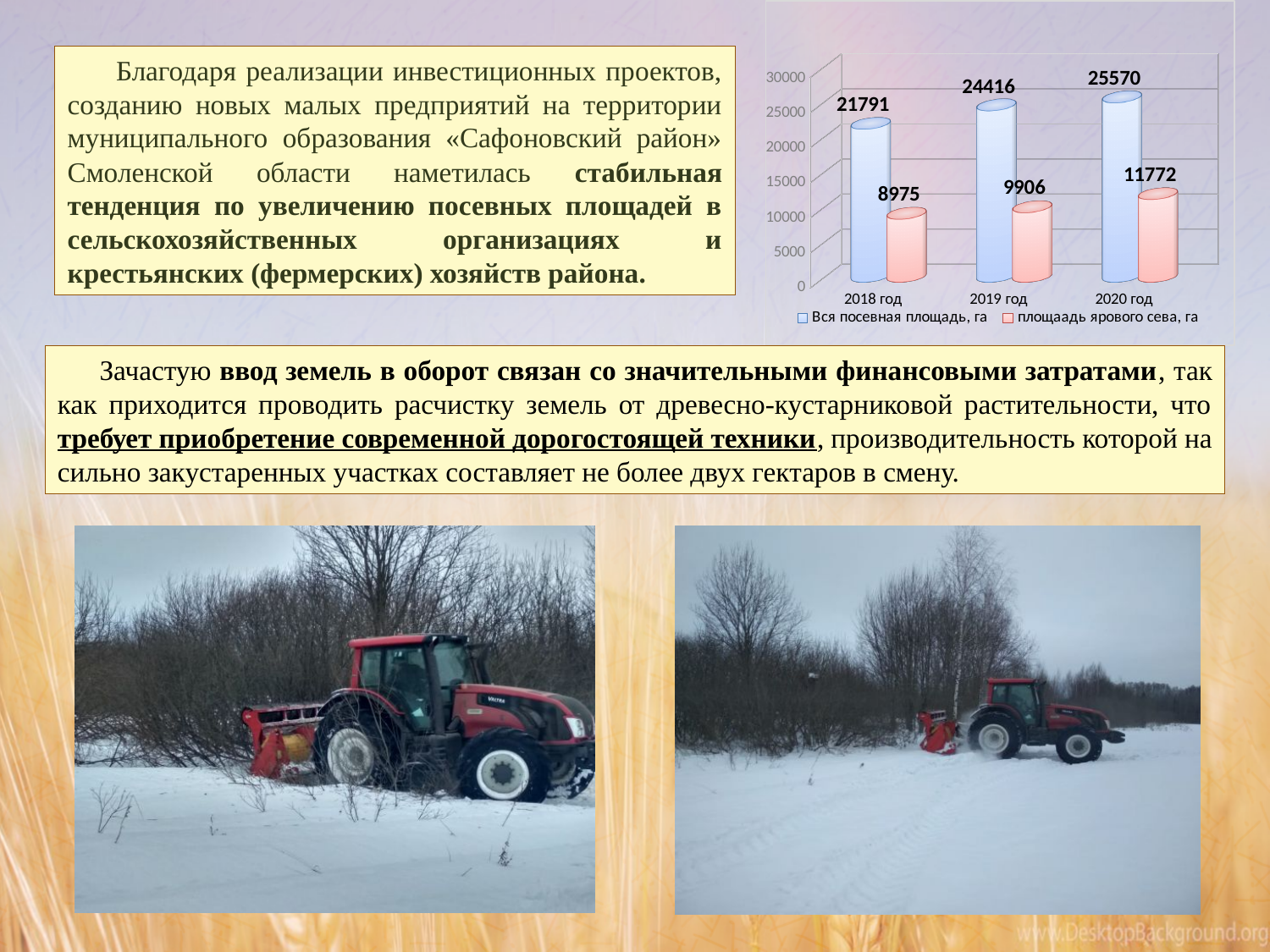
What is the value of 'площаадь ярового сева, га' for 2020 год? 11772 What kind of chart is shown on the slide? bar chart How many years are shown on the x axis of the chart? 3 Is the value of 'Вся посевная площадь, га' for 2018 год greater or less than 20000? greater In which year is 'Вся посевная площадь, га' the highest? 2020 год What is the value of 'площаадь ярового сева, га' for 2018 год? 8975 What is the value of 'Вся посевная площадь, га' for 2019 год? 24416 What is the difference between 'Вся посевная площадь, га' in 2020 год and in 2018 год? 3779 Which is larger: 'площаадь ярового сева, га' in 2020 год or in 2019 год? 2020 год How many series does the chart legend list? 2 In which year is 'площаадь ярового сева, га' the lowest? 2018 год What is the difference between 'Вся посевная площадь, га' and 'площаадь ярового сева, га' in 2019 год? 14510